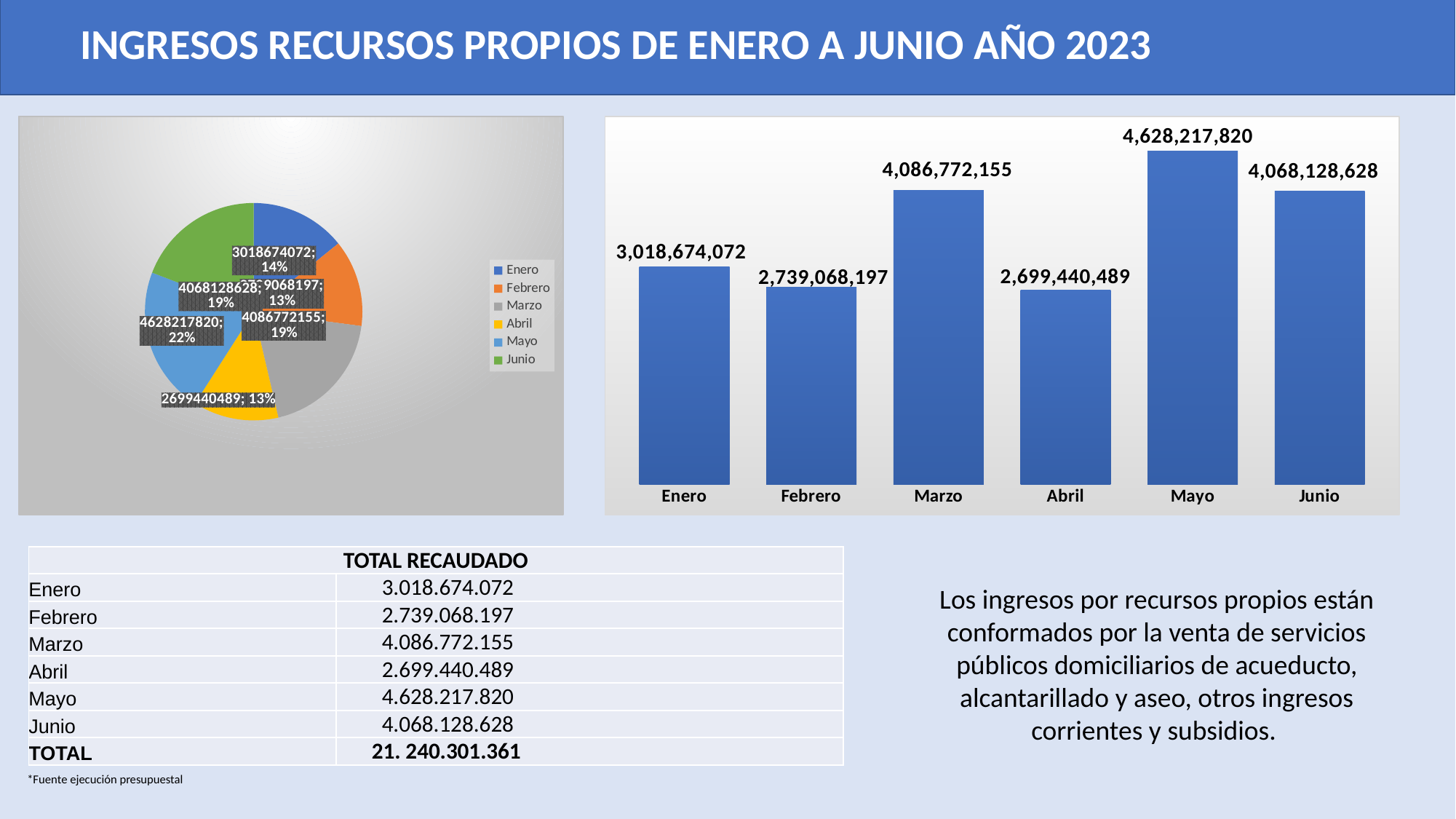
In the pie chart on the left, what share of the total does Enero represent? 14% In the bar chart on the right, what is the value for Mayo? 4,628,217,820 What kind of chart is shown on the right side of the slide? Bar chart In the bar chart on the right, which month has the highest value? Mayo In the bar chart on the right, what is the value for Abril? 2,699,440,489 In the pie chart on the left, what share of the total does Mayo represent? 22% How many months are shown in the bar chart on the right? 6 In the bar chart on the right, which is larger, the value for Marzo or the value for Junio? Marzo In the bar chart on the right, which month has the lowest value? Abril How many entries does the legend of the pie chart on the left list? 6 In the pie chart on the left, which colour represents Abril? Yellow In the bar chart on the right, what is the difference between the values for Mayo and Enero? 1,609,543,748